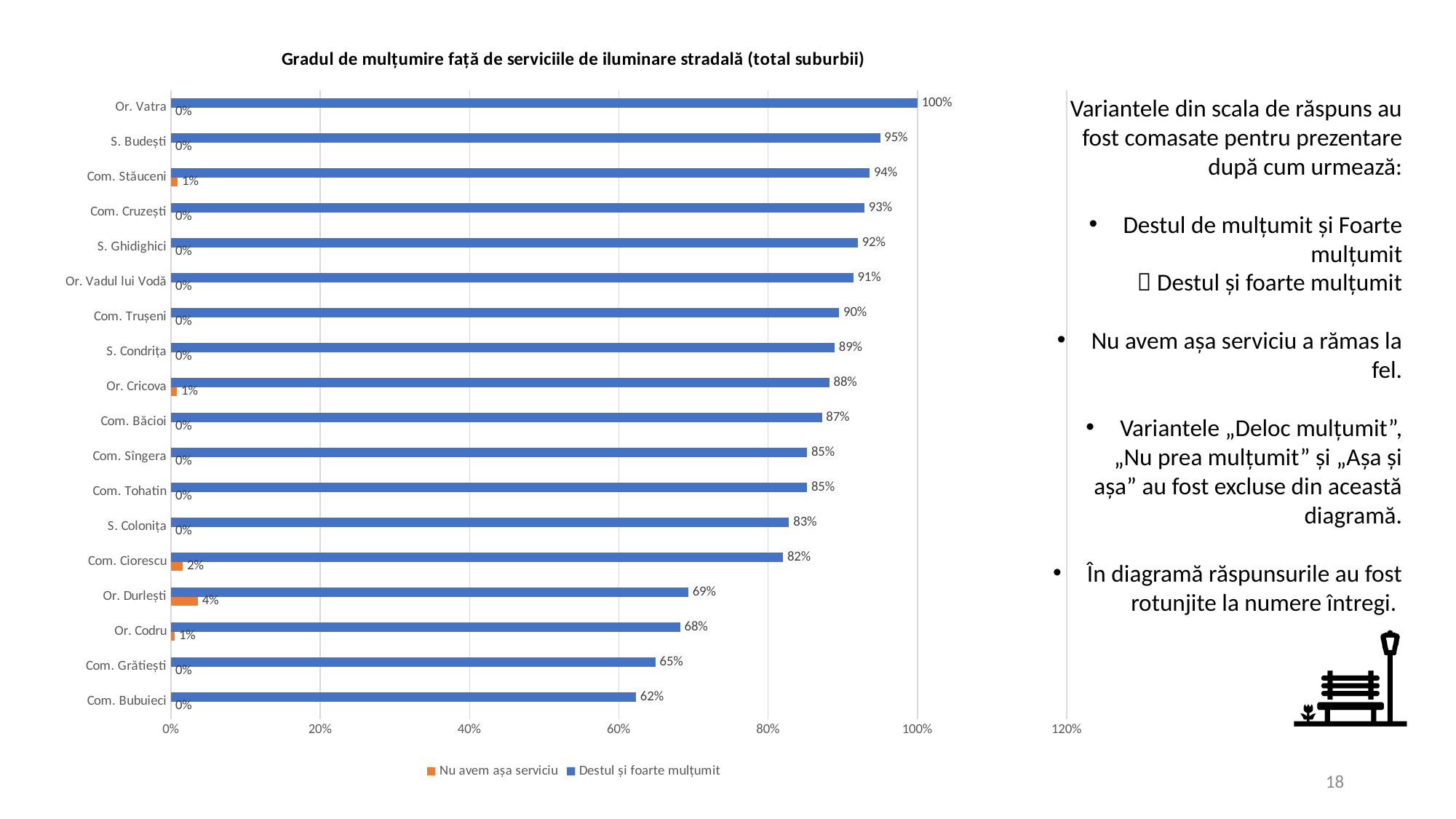
Which locality has the lowest 'Destul și foarte mulțumit' value? Com. Bubuieci What is the difference between the 'Destul și foarte mulțumit' values for S. Budești and Or. Codru? 27% What is the 'Nu avem așa serviciu' value for Or. Durlești? 4% What type of chart is shown on the slide? Bar chart How many series does the legend list? 2 Which locality has the highest 'Destul și foarte mulțumit' value? Or. Vatra What is the 'Destul și foarte mulțumit' value for Or. Vatra? 100% Which has a larger 'Destul și foarte mulțumit' value, Com. Ciorescu or Or. Durlești? Com. Ciorescu What is the title of the chart? Gradul de mulțumire față de serviciile de iluminare stradală (total suburbii) How many localities are listed on the chart? 18 What is the 'Destul și foarte mulțumit' value for Com. Bubuieci? 62% What is the 'Nu avem așa serviciu' value for Com. Ciorescu? 2%